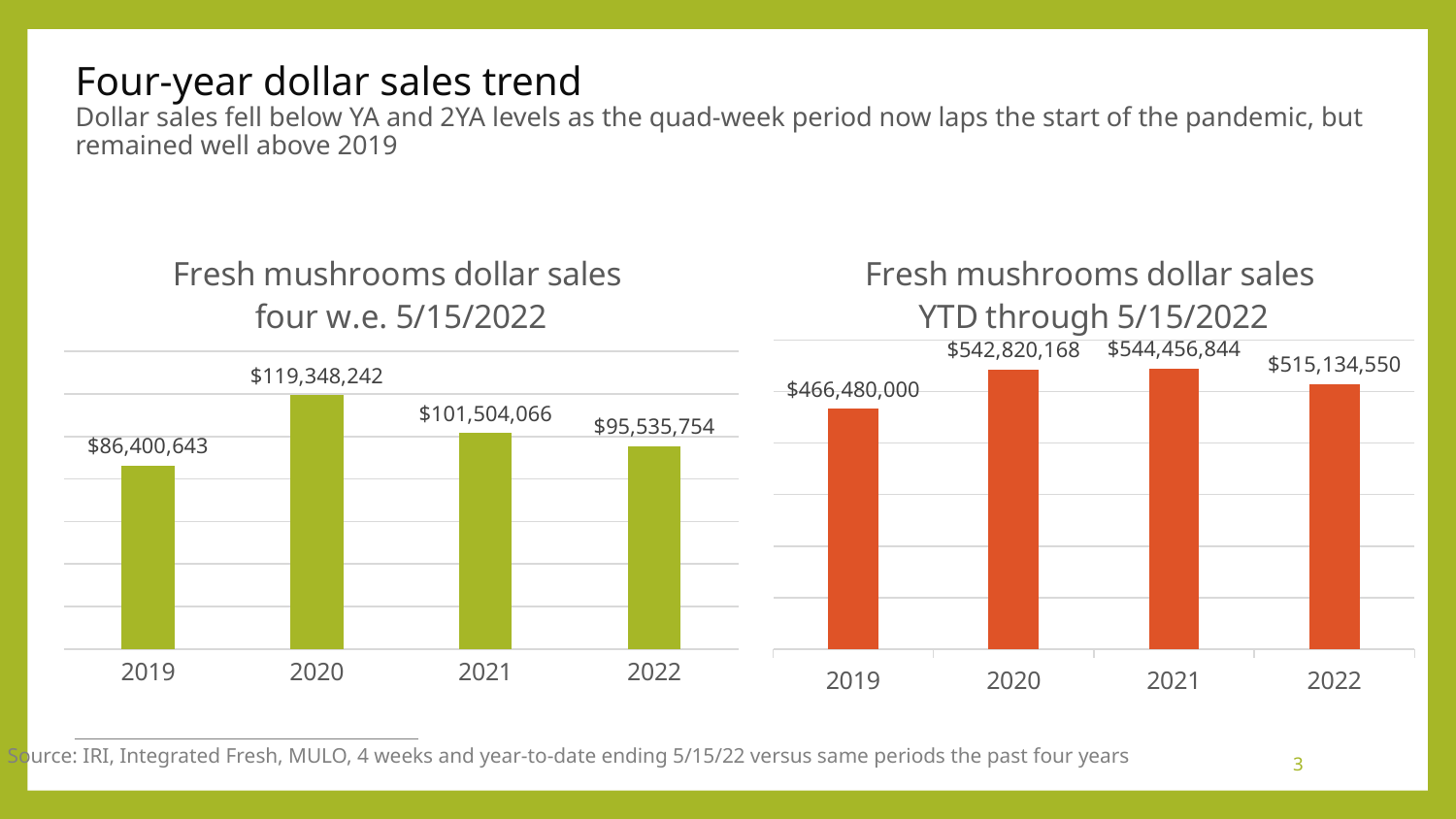
In the right chart (YTD through 5/15/2022), which year has the lowest dollar sales? 2019 In the left chart (four w.e. 5/15/2022), which is larger, the value for 2021 or the value for 2022? 2021 In the left chart (four w.e. 5/15/2022), what is the value for 2019? $86,400,643 In the left chart (four w.e. 5/15/2022), do the values rise or fall from 2020 to 2022? Fall What type of chart is the left chart (four w.e. 5/15/2022)? Bar chart In the chart titled "Fresh mushrooms dollar sales YTD through 5/15/2022", what is the value for 2022? $515,134,550 In the chart titled "Fresh mushrooms dollar sales four w.e. 5/15/2022", what is the value for 2020? $119,348,242 In the left chart (four w.e. 5/15/2022), which year has the highest dollar sales? 2020 In the right chart (YTD through 5/15/2022), how much higher is the 2022 value than the 2019 value? $48,654,550 How many years are shown on the x axis of the right chart (YTD through 5/15/2022)? 4 In the right chart (YTD through 5/15/2022), what is the value for 2019? $466,480,000 In the left chart (four w.e. 5/15/2022), what is the difference between the 2020 and 2019 values? $32,947,599